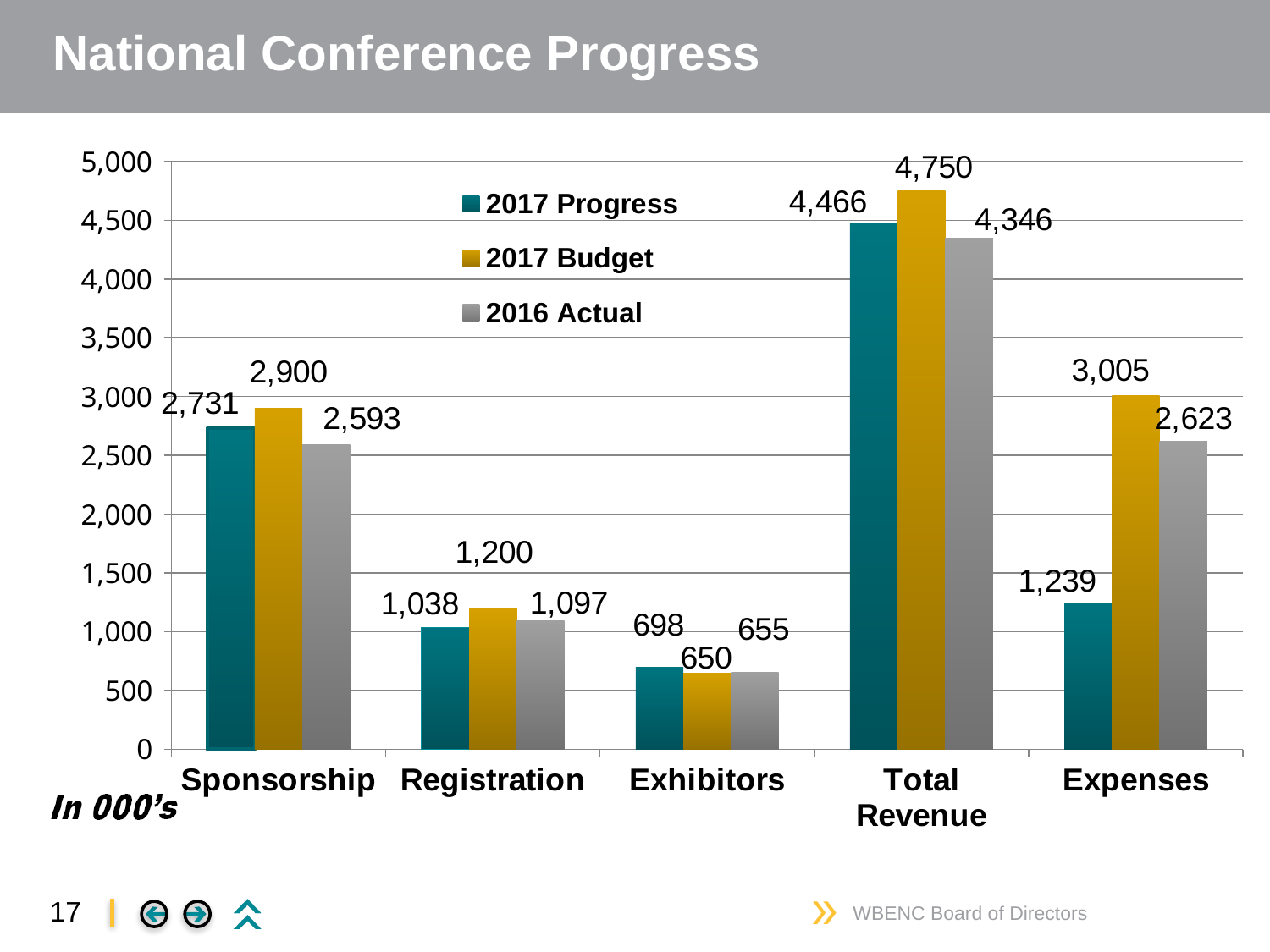
Which category has the lowest 2016 Actual value? Exhibitors What is the 2017 Budget value for Exhibitors? 650 What kind of chart is shown on the slide? Bar chart What unit note is shown below the chart? In 000's Which is larger for Registration: the 2017 Progress value or the 2016 Actual value? 2016 Actual What is the 2017 Progress value for Sponsorship? 2,731 What is the 2017 Budget value for Total Revenue? 4,750 How many series does the legend list? 3 Which category has the highest 2017 Progress value? Total Revenue What is the 2016 Actual value for Expenses? 2,623 How many categories are shown on the x axis? 5 What is the difference between the 2017 Budget and 2017 Progress values for Expenses? 1,766